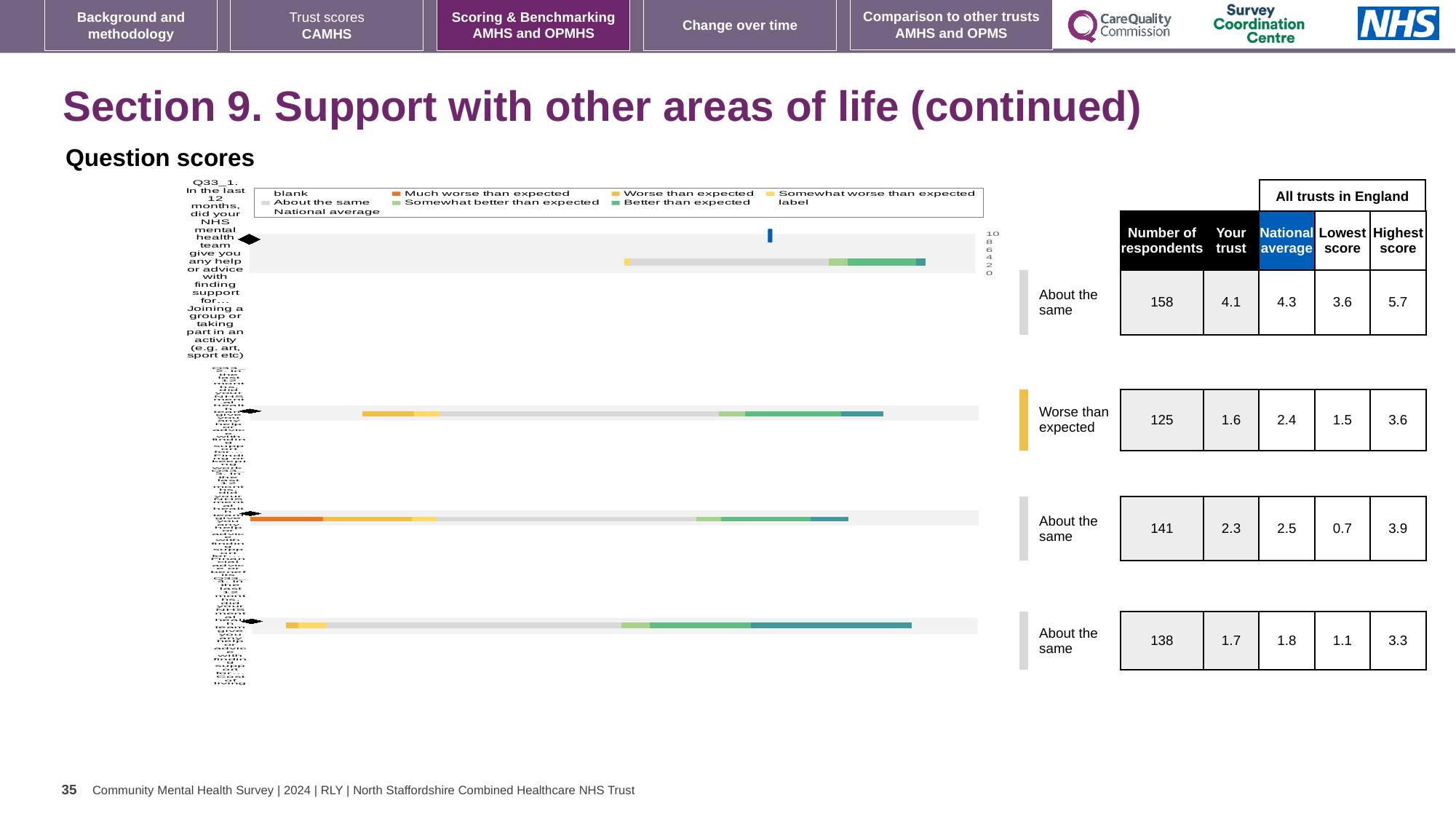
How many entries does the chart's legend list? 9 What rating label is printed beside the first bar of the chart (Joining a group or taking part in an activity)? About the same What kind of chart is shown under 'Question scores'? bar chart How many horizontal bars (question rows) does the chart contain? 4 In the table beside the chart, what is the number of respondents for the second row (Worse than expected)? 125 In the table beside the chart, what is the 'Your trust' score for the first row (Joining a group or taking part in an activity)? 4.1 In the table beside the chart, what is the highest score for the fourth row? 3.3 In the table beside the chart, which row has the highest 'Your trust' score? the first row (Joining a group or taking part in an activity) In the table beside the chart, is the 'Your trust' score for the third row larger or smaller than its national average? smaller What rating label is printed beside the second bar of the chart? Worse than expected In the table beside the chart, what is the difference between the national average and the 'Your trust' score for the second row (Worse than expected)? 0.8 Which legend entry is shown in orange in the chart? Much worse than expected